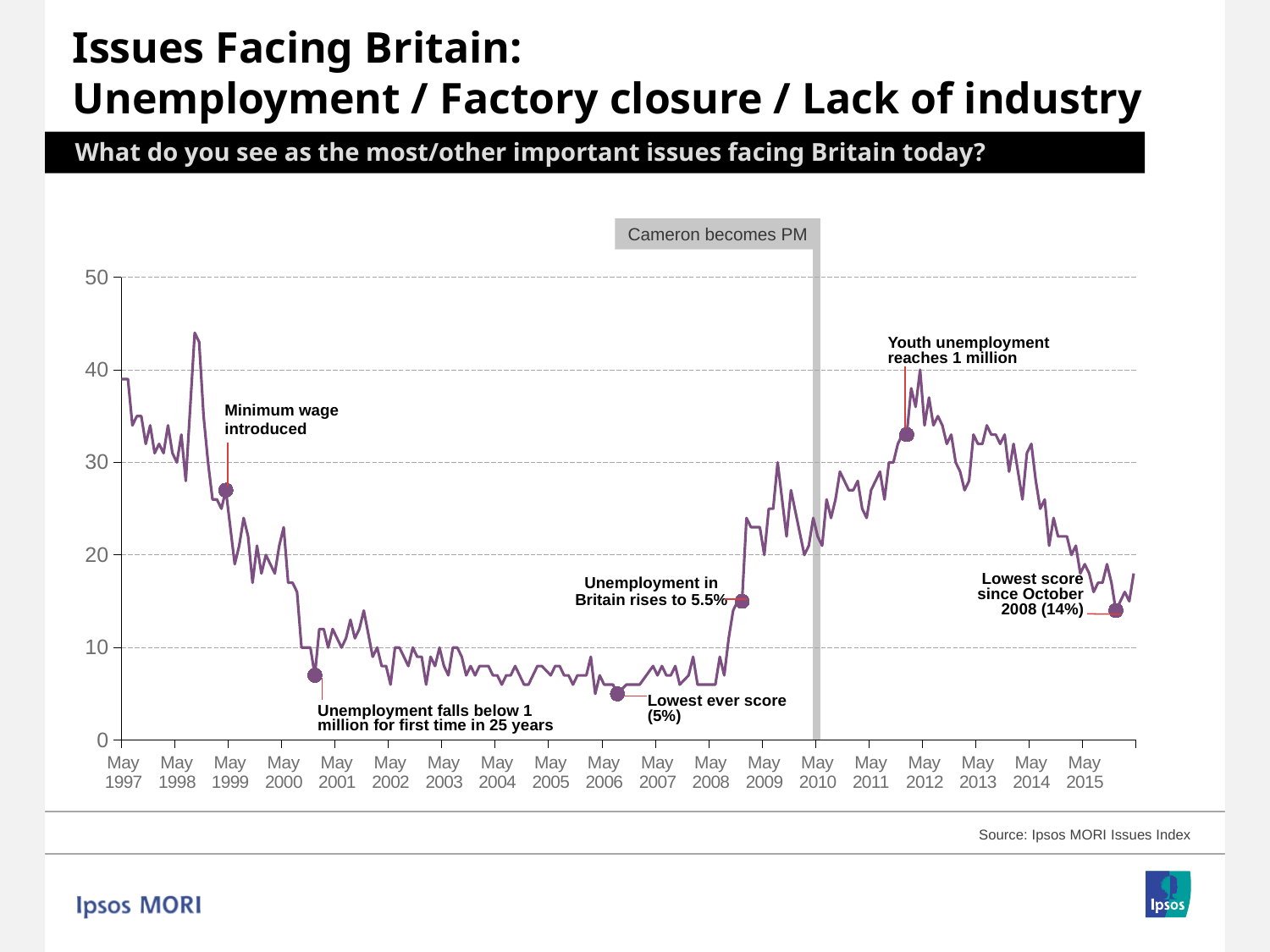
Does the line rise or fall between May 1997 and May 2001? fall Which is higher: the value at May 1997 or the value at May 2015? May 1997 How many year labels are shown on the x axis? 19 Is the value around May 2004 greater or less than 10? less What kind of chart is shown on the slide? line chart What is the difference between the lowest score since October 2008 (14%) and the lowest ever score (5%)? 9 percentage points Is the value at May 1997 greater or less than 30? greater Does the line rise or fall between May 2008 and May 2012? rise What was the lowest ever score recorded on the chart, as labelled? 5% What is the value labelled as the lowest score since October 2008? 14% Is the peak value in 1998 greater or less than 40? greater What event does the vertical grey bar on the chart mark? Cameron becomes PM